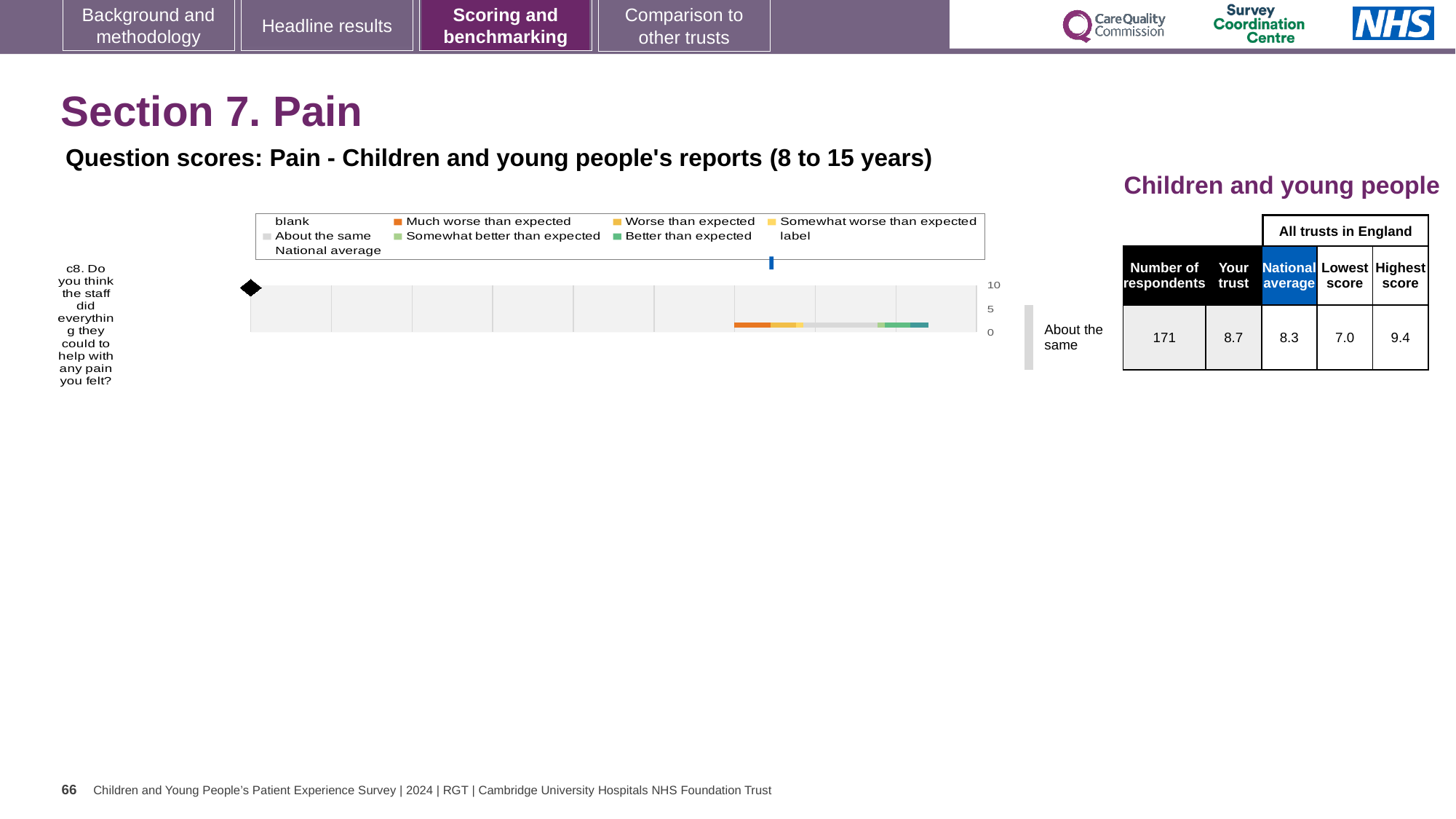
What is the difference between the highest and lowest scores among all trusts in England for question c8? 2.4 How many respondents answered question c8? 171 What is the difference between the 'Your trust' score and the national average for question c8? 0.4 Which colour in the legend represents 'Much worse than expected'? Orange What is the highest score among all trusts in England for question c8? 9.4 Which is higher for question c8: the 'Your trust' score or the national average? Your trust Which survey question is plotted in the chart? c8. Do you think the staff did everything they could to help with any pain you felt? How many survey questions are plotted in the chart? 1 What is the highest value shown on the chart's score axis? 10 What is the national average score for question c8? 8.3 What is the 'Your trust' score for question c8? 8.7 What kind of chart is shown on the slide? Bar chart